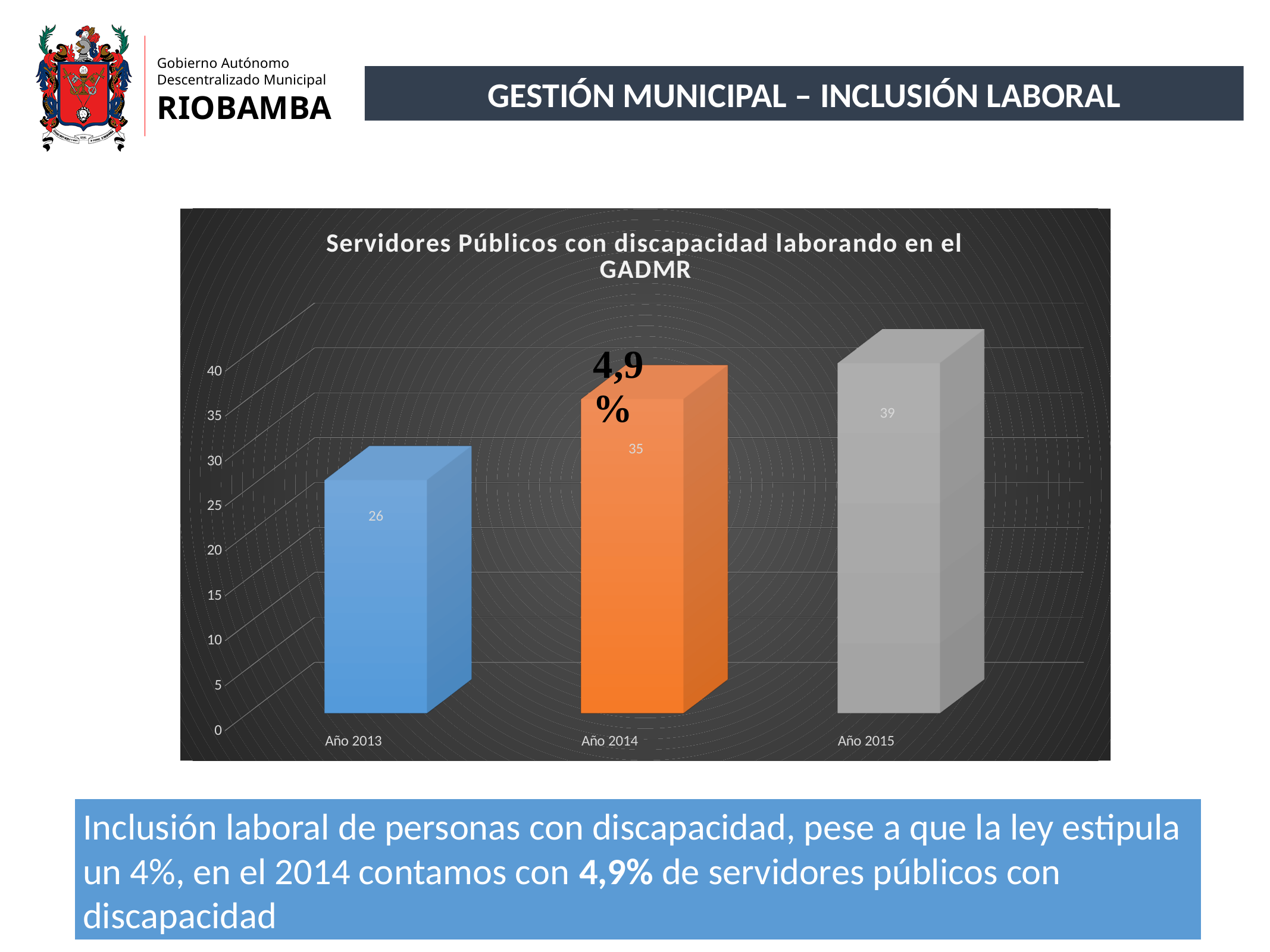
Which is larger, the value for Año 2014 or Año 2015? Año 2015 What is the value for Año 2015? 39 What is the difference between the values for Año 2015 and Año 2013? 13 Do the values rise or fall from Año 2013 to Año 2015? rise What is the value for Año 2013? 26 What kind of chart is shown? bar chart Which year has the lowest value? Año 2013 Which year has the highest value? Año 2015 Is the value for Año 2013 greater or less than 30? less What is the difference between the values for Año 2014 and Año 2013? 9 How many years are shown on the chart? 3 What is the value for Año 2014? 35